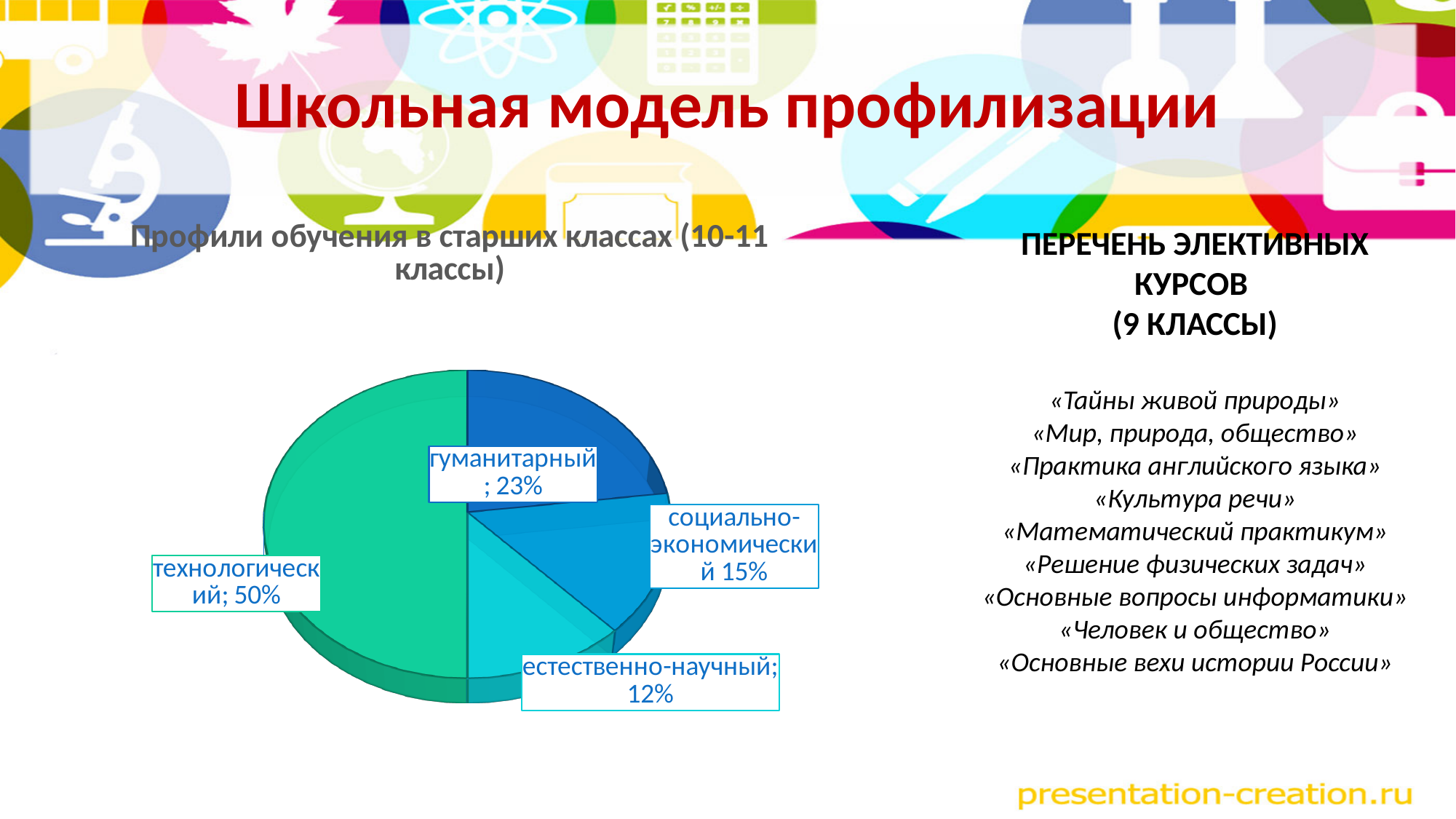
What is the difference in percentage points between the технологический and гуманитарный shares? 27 What share of the pie does the гуманитарный profile have? 23% Which is larger, the share for социально-экономический or for естественно-научный? социально-экономический Which profile has the smallest share of the pie? естественно-научный What type of chart is shown on the slide? pie chart What share of the pie does the технологический profile have? 50% What share of the pie does the социально-экономический profile have? 15% What is the combined share of the гуманитарный and социально-экономический slices? 38% What share of the pie does the естественно-научный profile have? 12% Which profile has the largest share of the pie? технологический What is the title of the chart on the slide? Профили обучения в старших классах (10-11 классы) How many slices does the pie chart have? 4